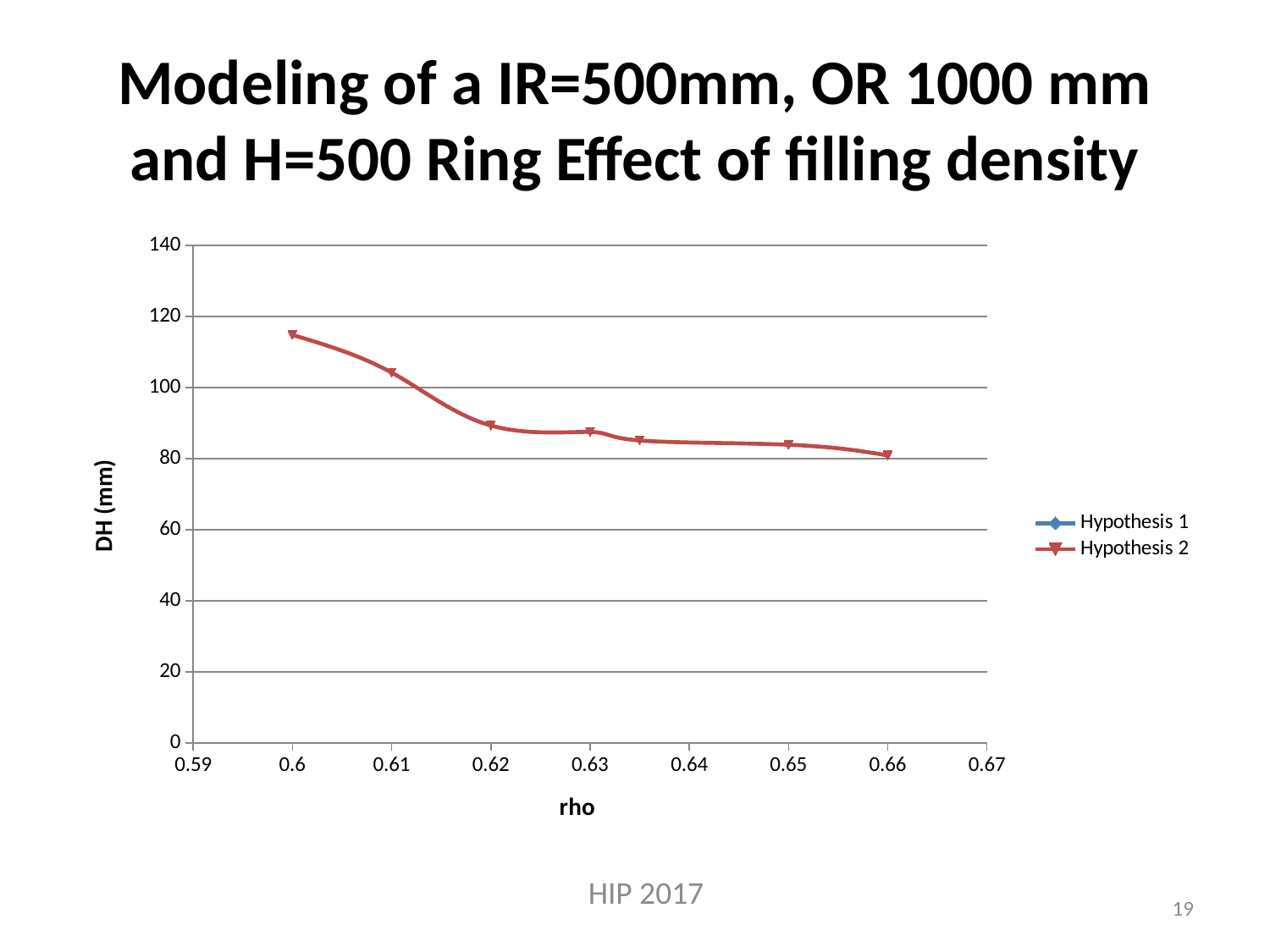
What kind of chart is shown on the slide? line chart Which is larger for Hypothesis 2: the value at rho = 0.61 or the value at rho = 0.65? rho = 0.61 How many series does the legend list? 2 What are the names of the series listed in the legend? Hypothesis 1 and Hypothesis 2 At which rho value is DH (mm) for Hypothesis 2 highest? 0.6 Does DH (mm) for Hypothesis 2 rise or fall as rho increases? fall How many data points are plotted for Hypothesis 2? 7 What is the label of the y axis? DH (mm) Is the Hypothesis 2 value at rho = 0.62 greater or less than 100? less Is the Hypothesis 2 value at rho = 0.6 greater or less than 100? greater At which rho value is DH (mm) for Hypothesis 2 lowest? 0.66